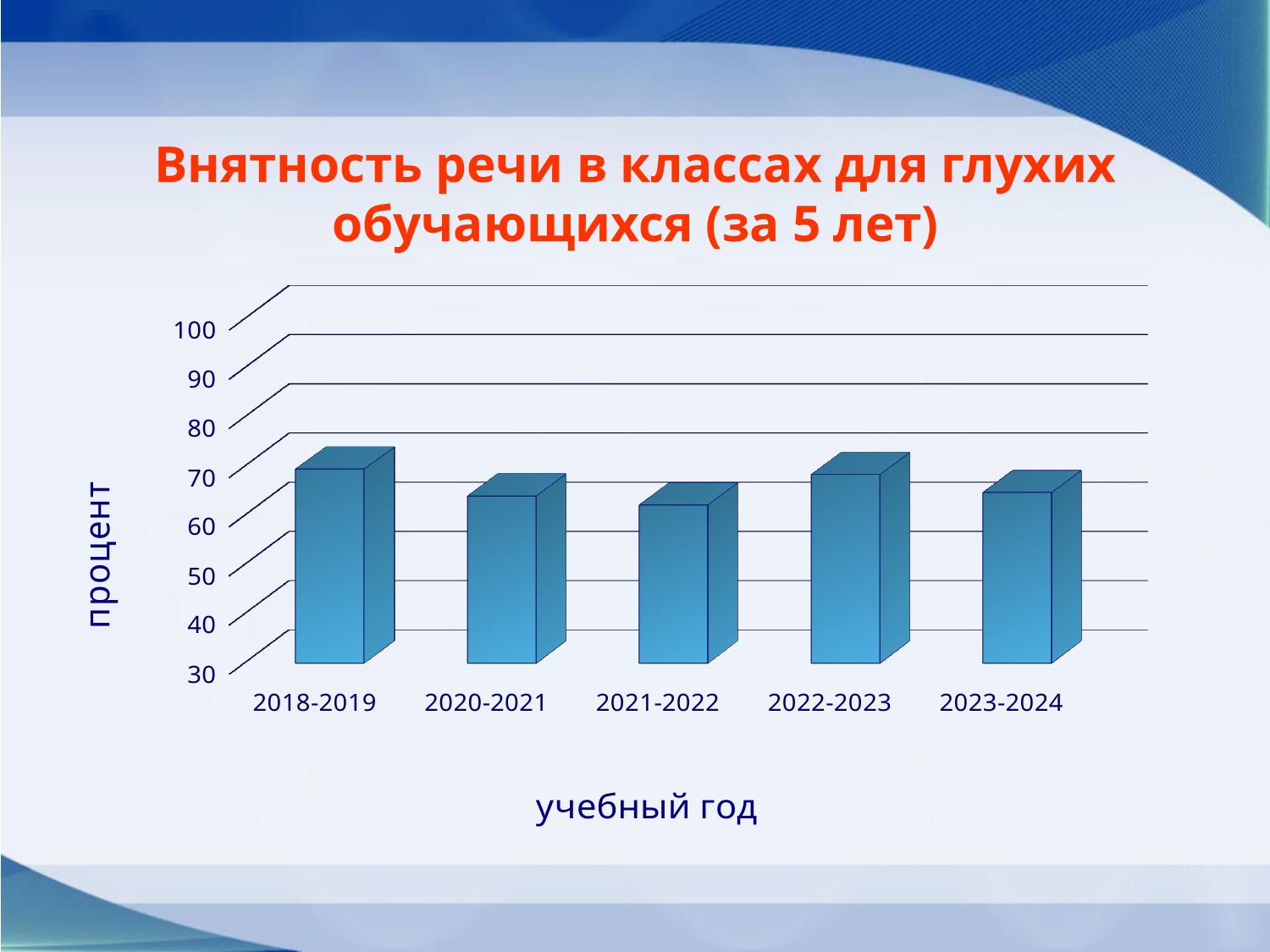
What is the label of the vertical axis? процент Which is larger, the value for 2018-2019 or the value for 2021-2022? 2018-2019 Is the value for 2022-2023 greater or less than 60? greater How many academic years (categories) are shown on the x axis? 5 Is the value for 2018-2019 greater or less than 60? greater Is the value for 2021-2022 greater or less than 70? less What kind of chart is shown on the slide? bar chart What is the label of the horizontal axis? учебный год Which is larger, the value for 2022-2023 or the value for 2021-2022? 2022-2023